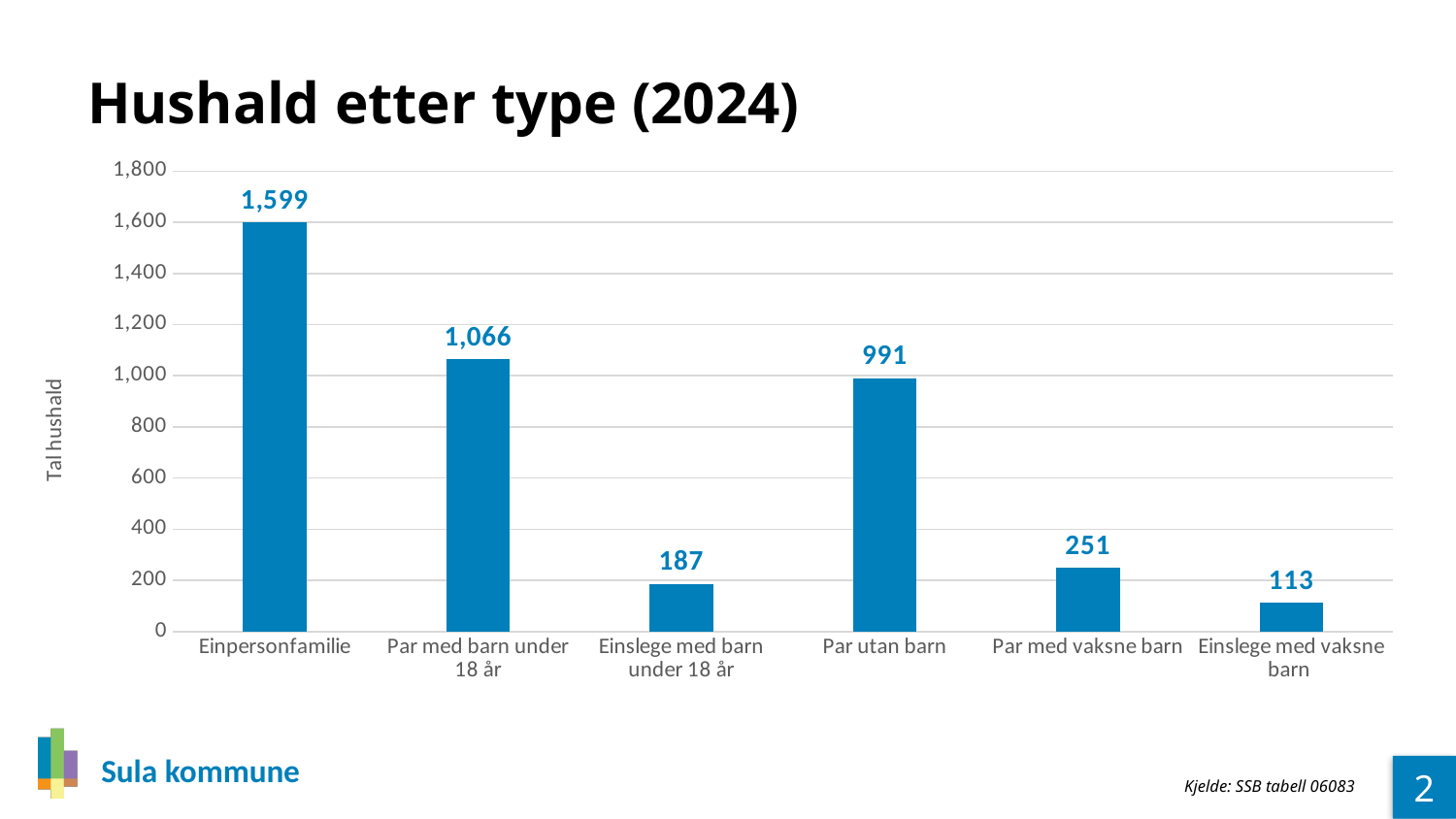
Which household type has the lowest number of households? Einslege med vaksne barn What is the value for Einslege med vaksne barn? 113 What is the title of the chart? Hushald etter type (2024) Is the value for Par med barn under 18 år greater or less than 1,000? greater Which household type has the highest number of households? Einpersonfamilie How many household types are shown in the chart? 6 What is the difference between Par med barn under 18 år and Par utan barn? 75 What is the value for Einpersonfamilie? 1,599 What is the difference between Par med vaksne barn and Einslege med barn under 18 år? 64 What is the value for Par utan barn? 991 What kind of chart is shown on the slide? Bar chart Which is larger, Par med vaksne barn or Einslege med barn under 18 år? Par med vaksne barn